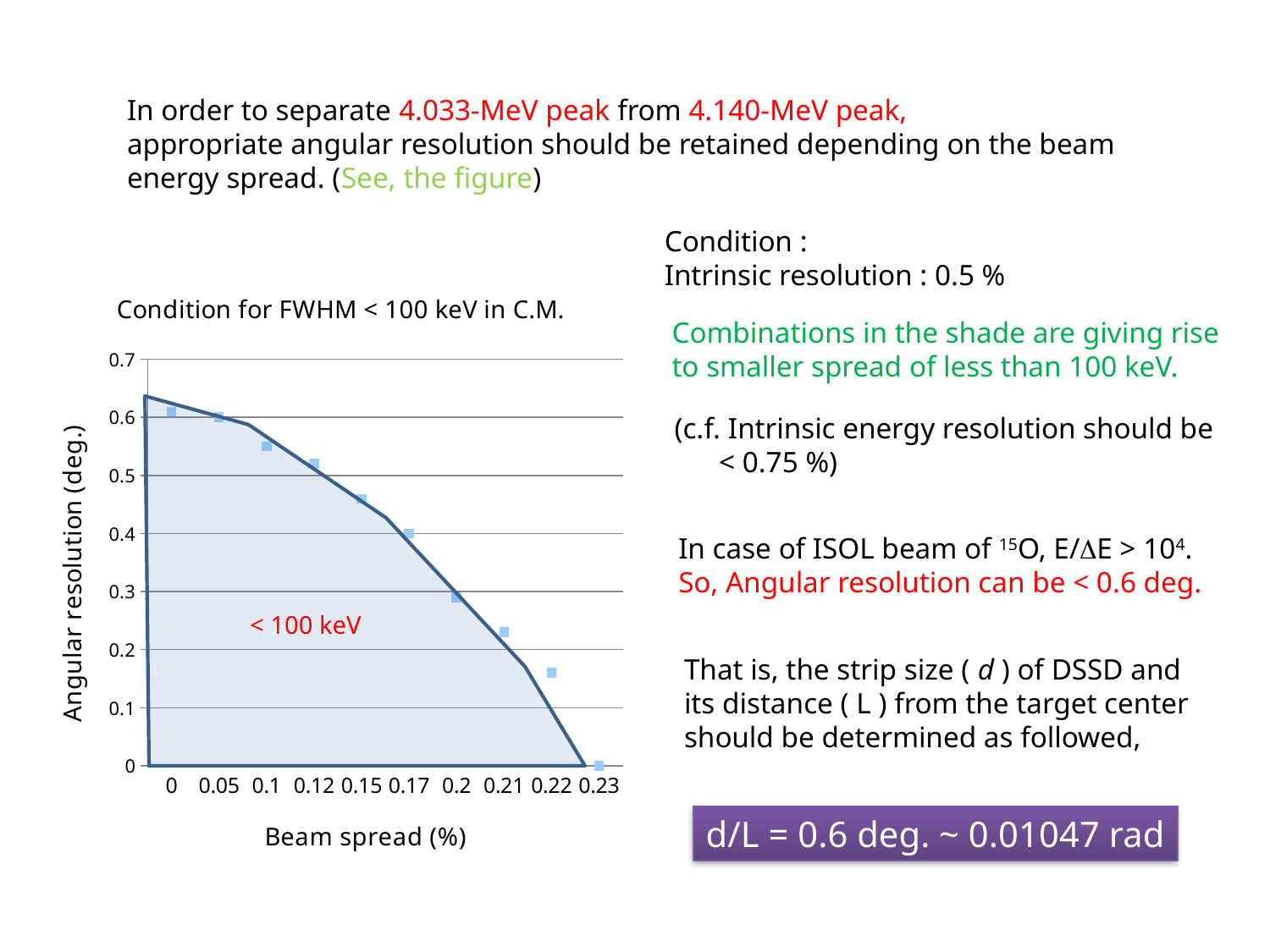
Is the angular resolution value at a beam spread of 0.15 greater or less than 0.4? greater Which has the larger angular resolution value, a beam spread of 0.1 or a beam spread of 0.2? 0.1 How many beam spread categories are shown on the x axis of the chart? 10 Which has the larger angular resolution value, a beam spread of 0.22 or a beam spread of 0.15? 0.15 What is the title of the chart? Condition for FWHM < 100 keV in C.M. What is the angular resolution value plotted at a beam spread of 0.23? 0 Is the angular resolution value at a beam spread of 0 greater or less than 0.5? greater Is the angular resolution value at a beam spread of 0.22 greater or less than 0.2? less Which beam spread category has the lowest angular resolution value? 0.23 Do the angular resolution values rise or fall as beam spread increases along the x axis? fall What is the label of the x axis of the chart? Beam spread (%)